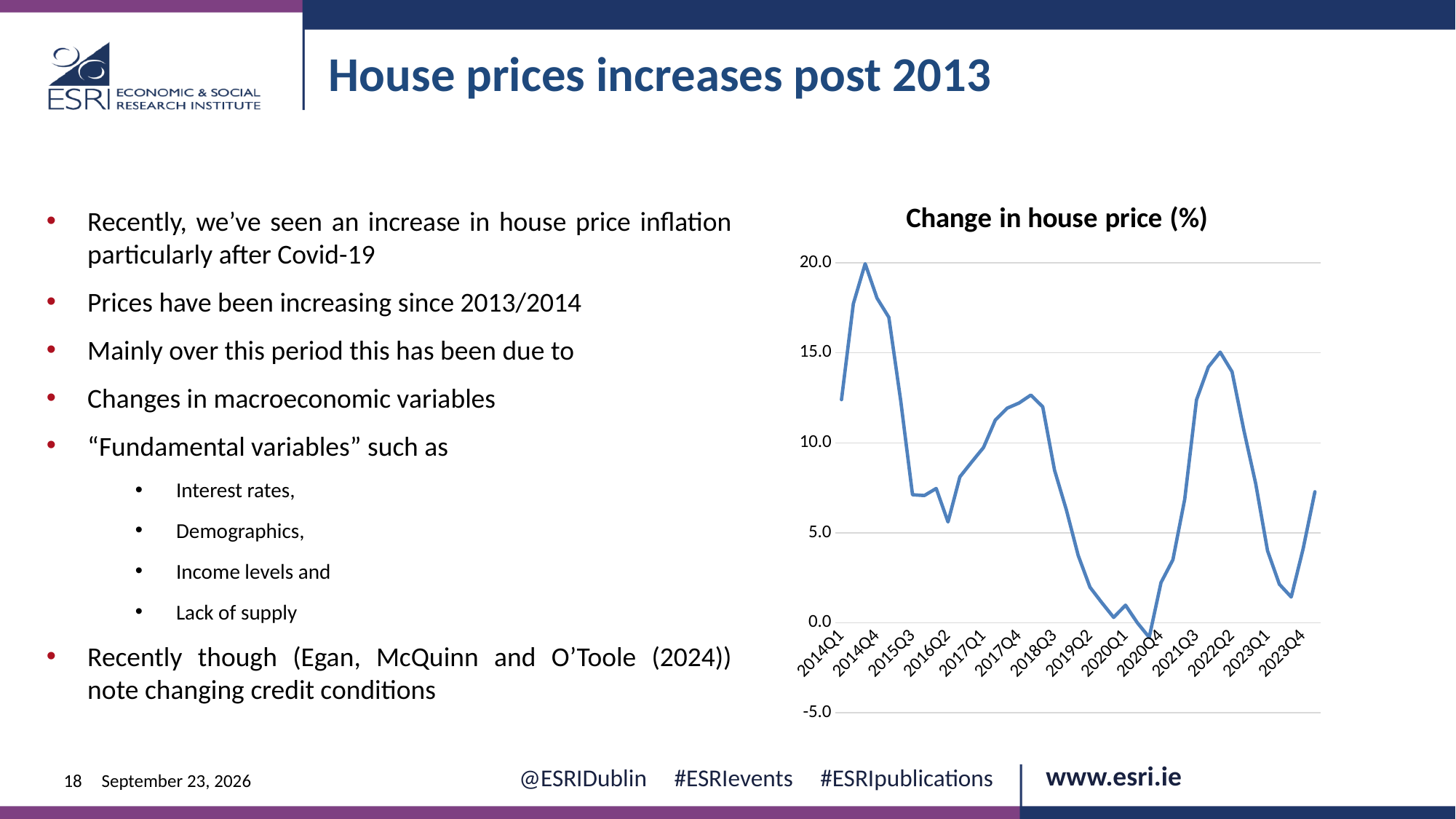
Is the value for 2023Q4 greater or less than 5? less Which has the larger value, 2014Q1 or 2023Q4? 2014Q1 What kind of chart is shown on the slide? line chart Does the line rise or fall between 2022Q2 and 2023Q1? fall What is the title of the chart? Change in house price (%) Is the value for 2014Q1 greater or less than 10? greater Which has the larger value, 2017Q4 or 2020Q1? 2017Q4 Is the value for 2017Q4 greater or less than 10? greater How many quarter labels are shown on the x axis of the chart? 14